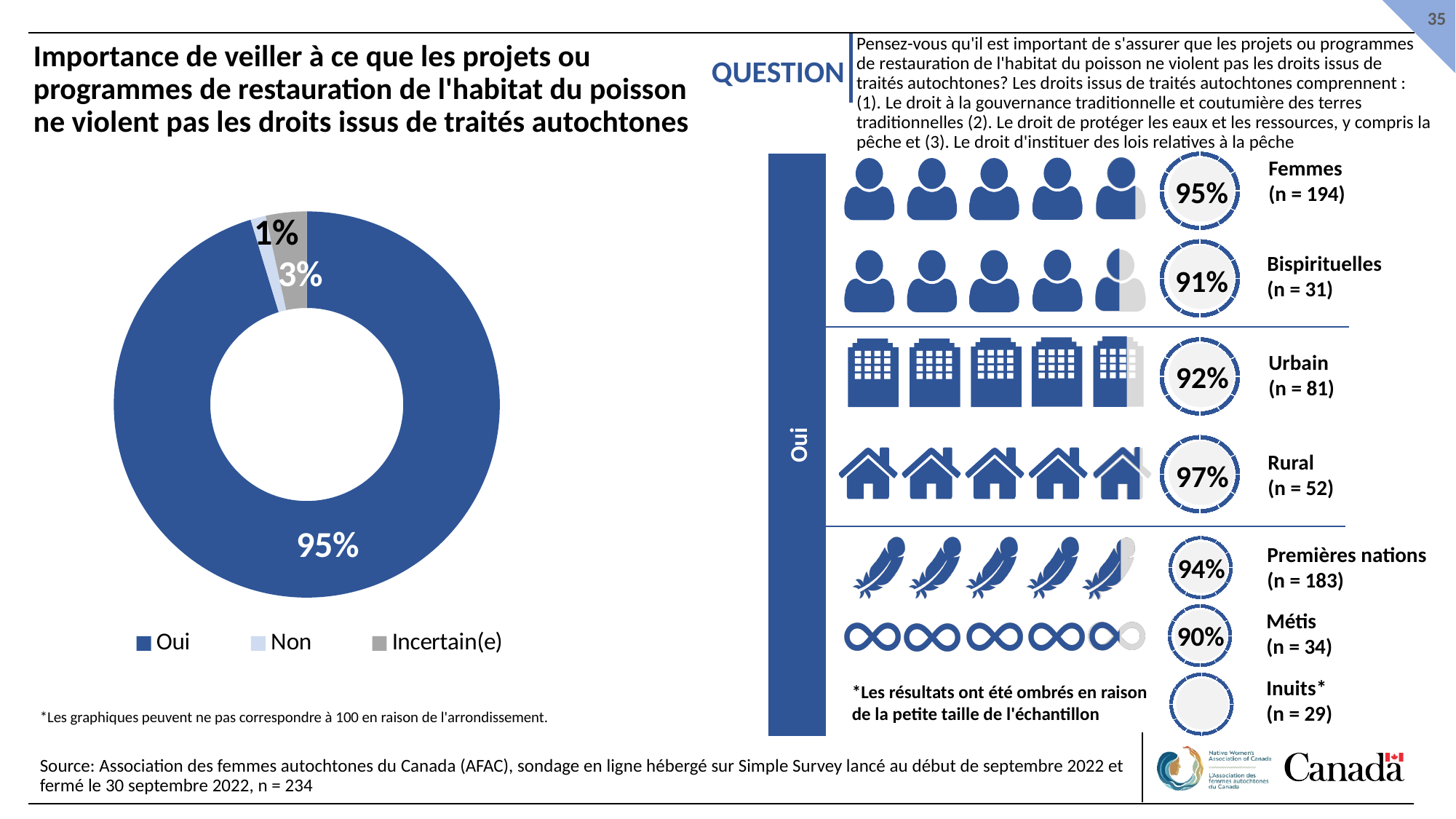
What type of chart is shown on the left side of the slide? Donut (pie) chart In the donut chart on the left, what is the difference in percentage points between "Oui" and "Incertain(e)"? 92 In the donut chart on the left, how many categories does the legend list? 3 In the donut chart on the left, what percentage of respondents answered "Oui"? 95% In the subgroup infographic on the right, which subgroup has the highest "Oui" percentage shown? Rural In the subgroup infographic on the right, what percentage of Rural respondents (n = 52) answered "Oui"? 97% In the donut chart on the left, what percentage of respondents answered "Incertain(e)"? 3% In the subgroup infographic on the right, is the "Oui" percentage for Urbain or for Bispirituelles larger? Urbain In the donut chart on the left, which response category has the largest share? Oui In the donut chart on the left, which response category has the smallest share? Non In the subgroup infographic on the right, what percentage of Métis respondents (n = 34) answered "Oui"? 90% In the donut chart on the left, what percentage of respondents answered "Non"? 1%